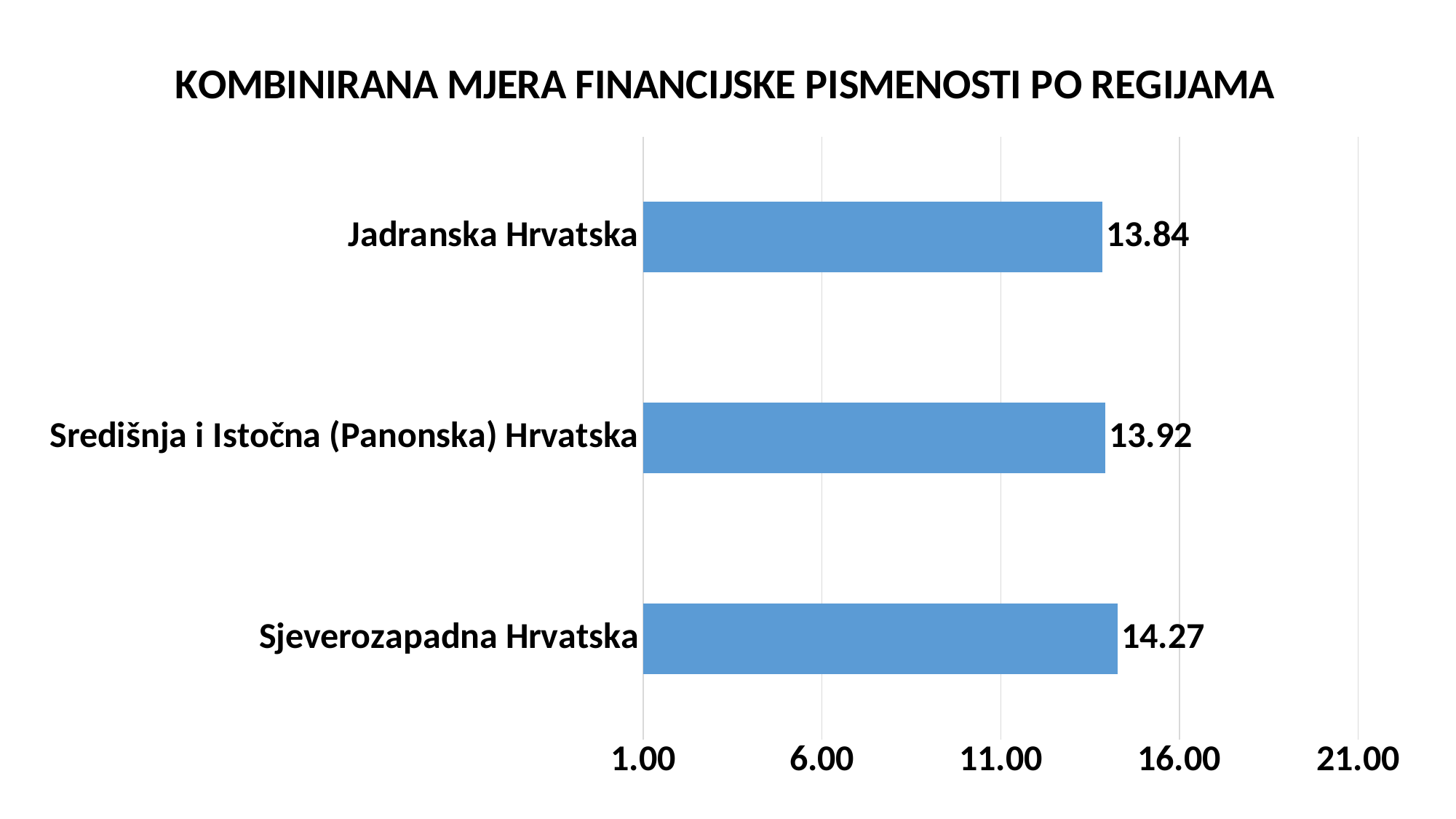
Which region has the highest value? Sjeverozapadna Hrvatska What is the difference between the values for Sjeverozapadna Hrvatska and Jadranska Hrvatska? 0.43 Which region has the lowest value? Jadranska Hrvatska Which is larger, the value for Sjeverozapadna Hrvatska or the value for Središnja i Istočna (Panonska) Hrvatska? Sjeverozapadna Hrvatska What is the value for Sjeverozapadna Hrvatska? 14.27 What is the difference between the values for Središnja i Istočna (Panonska) Hrvatska and Jadranska Hrvatska? 0.08 What is the value for Jadranska Hrvatska? 13.84 What is the value for Središnja i Istočna (Panonska) Hrvatska? 13.92 How many regions are shown in the chart? 3 What is the title of the chart? KOMBINIRANA MJERA FINANCIJSKE PISMENOSTI PO REGIJAMA Is the value for Sjeverozapadna Hrvatska greater or less than 16.00? less What kind of chart is shown on the slide? Bar chart